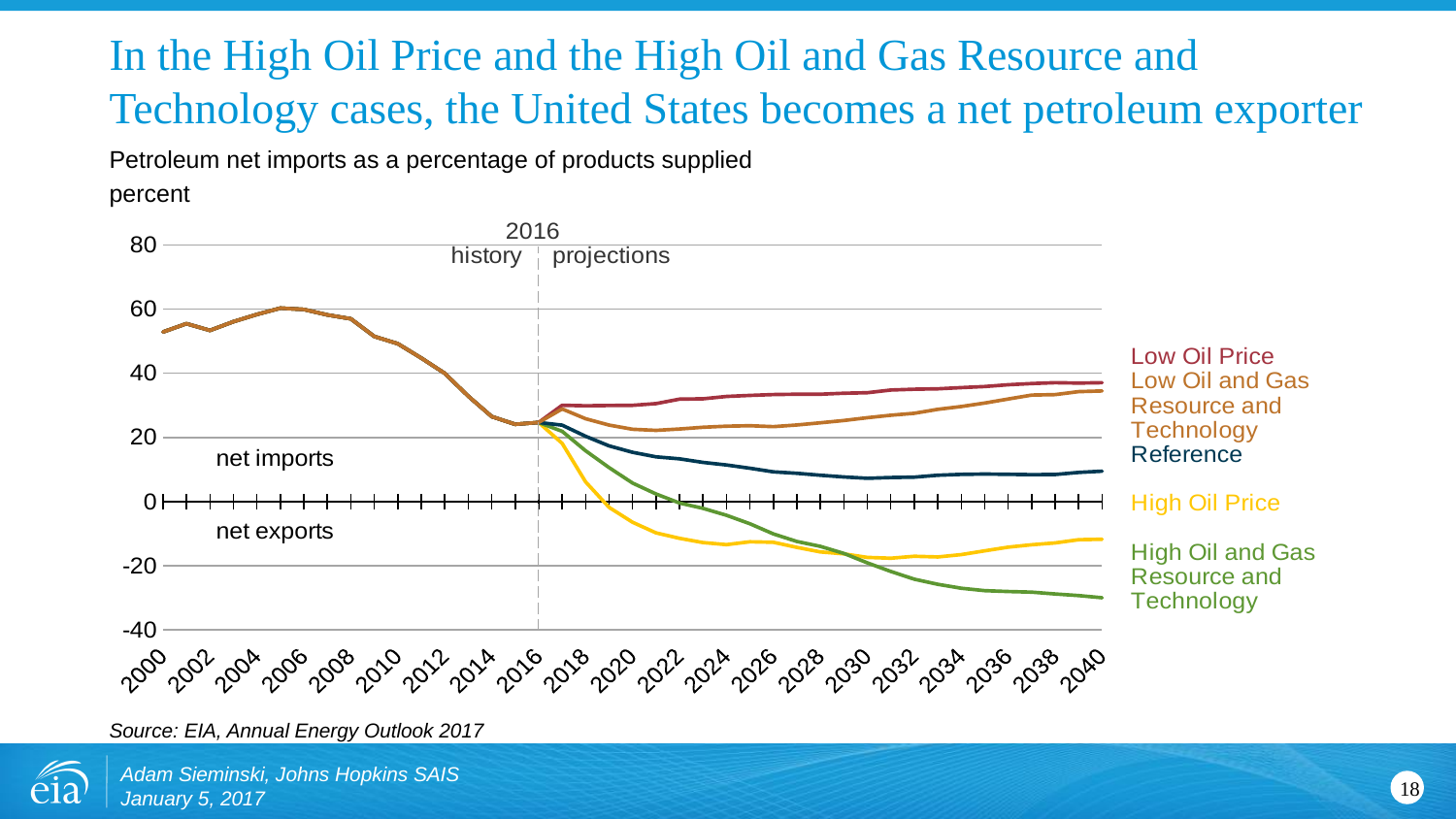
Is the value in 2005 greater or less than 40? greater Which series is the first to cross below 0 into net exports? High Oil Price Is the value for Reference in 2040 greater or less than 20? less Is the value for High Oil and Gas Resource and Technology in 2040 greater or less than -20? less In 2040, which is larger: the Reference value or the High Oil Price value? Reference What kind of chart is shown on the slide? line chart Which series has the lowest value in 2040? High Oil and Gas Resource and Technology How many series (cases) does the legend list? 5 Does the Low Oil Price series rise or fall between 2020 and 2040? rise Which year separates history from projections on the chart? 2016 Does the Reference series rise or fall between 2016 and 2040? fall